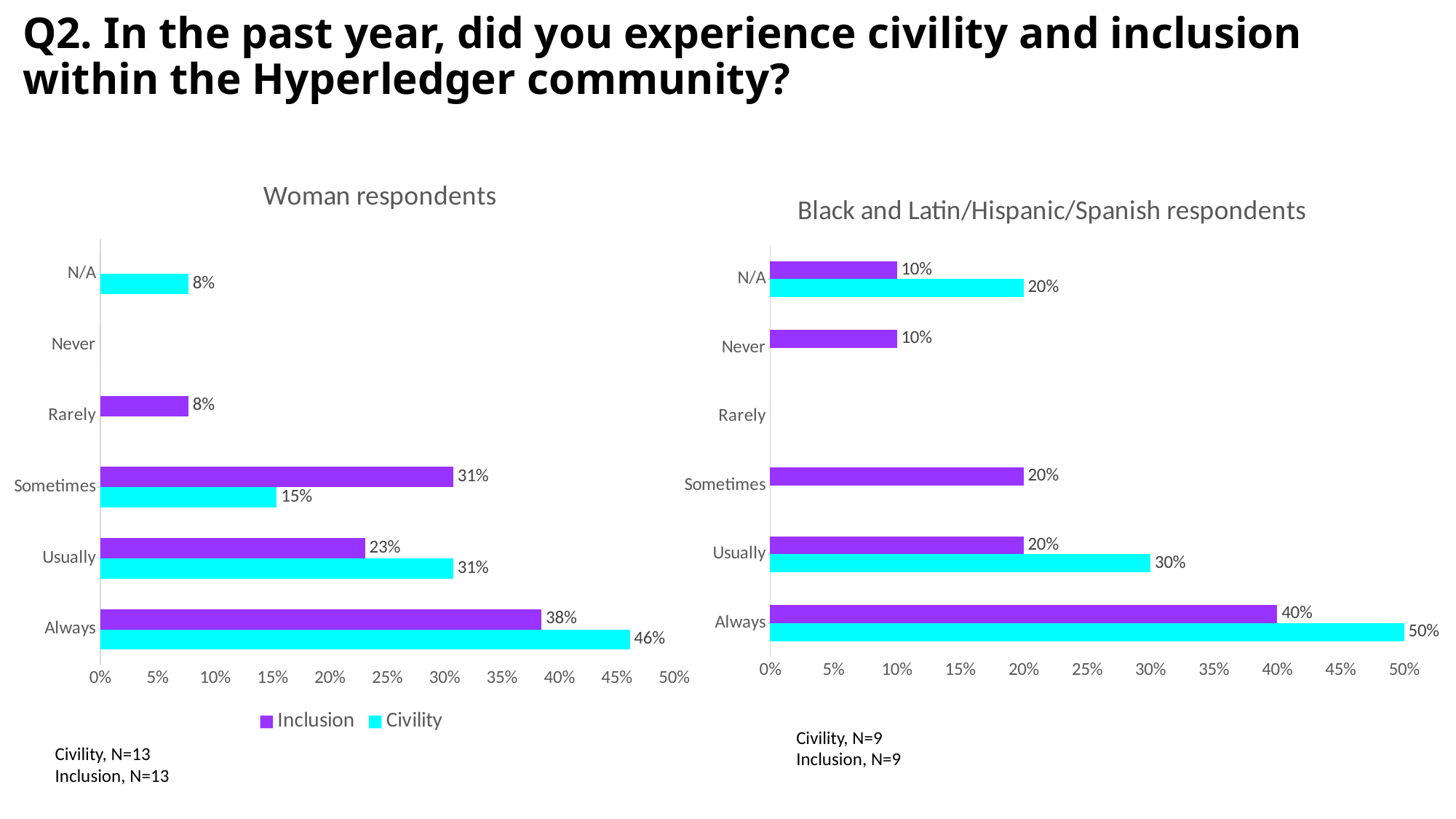
How many series does the legend list on the slide? 2 In the 'Black and Latin/Hispanic/Spanish respondents' chart, what is the Civility value for Usually? 30% In the 'Black and Latin/Hispanic/Spanish respondents' chart, what is the Inclusion value for Never? 10% In the 'Woman respondents' chart, what is the difference between the Civility and Inclusion values for Always? 8% In the 'Woman respondents' chart, what is the Civility value for Always? 46% In the 'Woman respondents' chart, what is the Inclusion value for Sometimes? 31% In the 'Woman respondents' chart, which is larger for Usually: Inclusion or Civility? Civility In the 'Woman respondents' chart, which category has the highest Inclusion value? Always What kind of chart is the 'Black and Latin/Hispanic/Spanish respondents' chart? Bar chart In the 'Black and Latin/Hispanic/Spanish respondents' chart, what is the difference between the Civility and Inclusion values for N/A? 10% How many categories are shown on the y axis of the 'Woman respondents' chart? 6 In the 'Black and Latin/Hispanic/Spanish respondents' chart, which category has the highest Civility value? Always